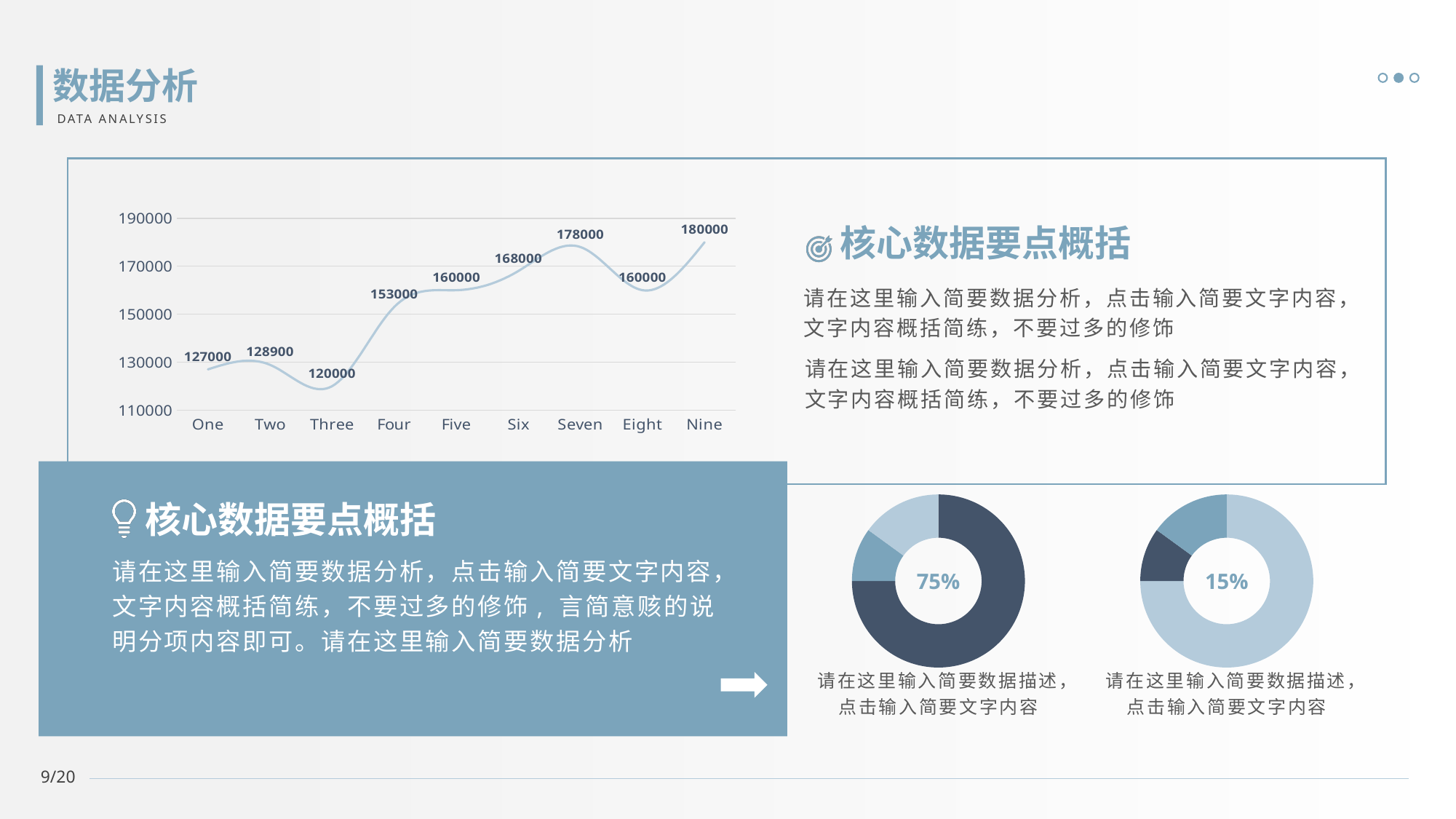
In the line chart at the top left, which category has the highest value? Nine In the line chart at the top left, what is the value for Four? 153000 In the line chart at the top left, what is the difference between the values for Nine and Three? 60000 In the line chart at the top left, which category has the lowest value? Three In the line chart at the top left, which is larger, the value for Seven or the value for Eight? Seven In the line chart at the top left, what is the difference between the values for Six and Five? 8000 In the line chart at the top left, how many categories are shown on the x axis? 9 In the line chart at the top left, what is the value for Two? 128900 In the line chart at the top left, do the values generally rise or fall from One to Nine? rise In the line chart at the top left, what is the value for Seven? 178000 What percentage is shown in the centre of the left donut chart at the bottom right of the slide? 75% What kind of chart is the chart at the top left of the slide? line chart